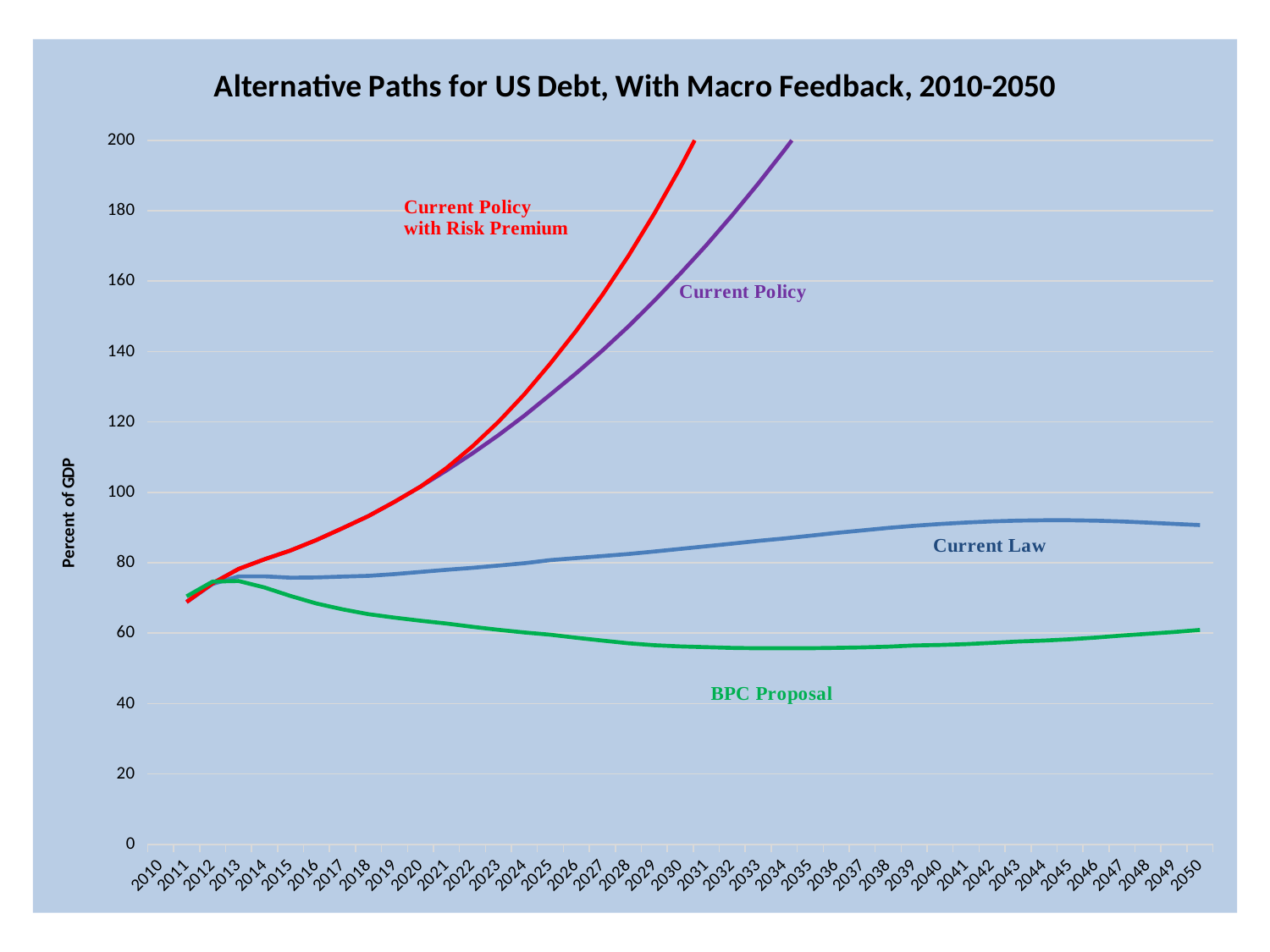
Which series is the lowest in 2050? BPC Proposal What kind of chart is shown on the slide? Line chart Which series reaches 200 percent of GDP first? Current Policy with Risk Premium In 2030, which is higher: Current Policy with Risk Premium or Current Policy? Current Policy with Risk Premium What is the title of the chart? Alternative Paths for US Debt, With Macro Feedback, 2010-2050 Which series is the highest in 2050 among the lines still plotted at that year? Current Law What is the label on the vertical axis of the chart? Percent of GDP How many years are labeled along the x axis? 41 Does the BPC Proposal line rise or fall between 2013 and 2035? Fall How many series (lines) are labeled on the chart? 4 Is the value for BPC Proposal in 2035 greater or less than 60? less Is the value for Current Law in 2040 greater or less than 80? greater